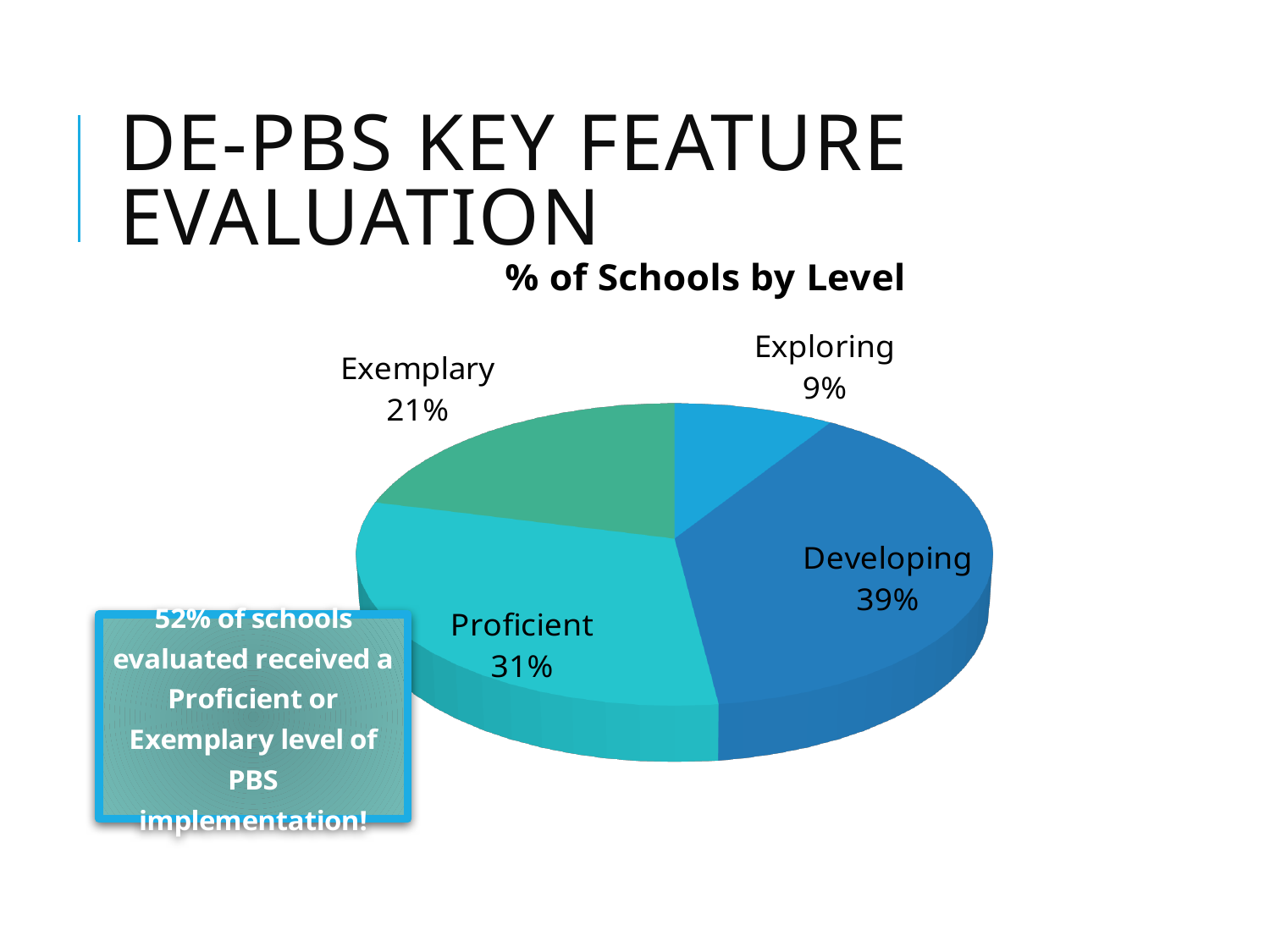
What type of chart is shown on the slide? Pie chart What is the combined share of schools at the Proficient and Exemplary levels? 52% What is the title of the chart? % of Schools by Level What percentage of schools are at the Exploring level? 9% Which level has a larger share of schools, Exemplary or Proficient? Proficient What percentage of schools are at the Proficient level? 31% What is the difference in percentage points between the Developing and Proficient levels? 8 Which level has the smallest share of schools? Exploring How many levels are shown in the pie chart? 4 Which level has the largest share of schools? Developing What percentage of schools are at the Developing level? 39% What percentage of schools are at the Exemplary level? 21%